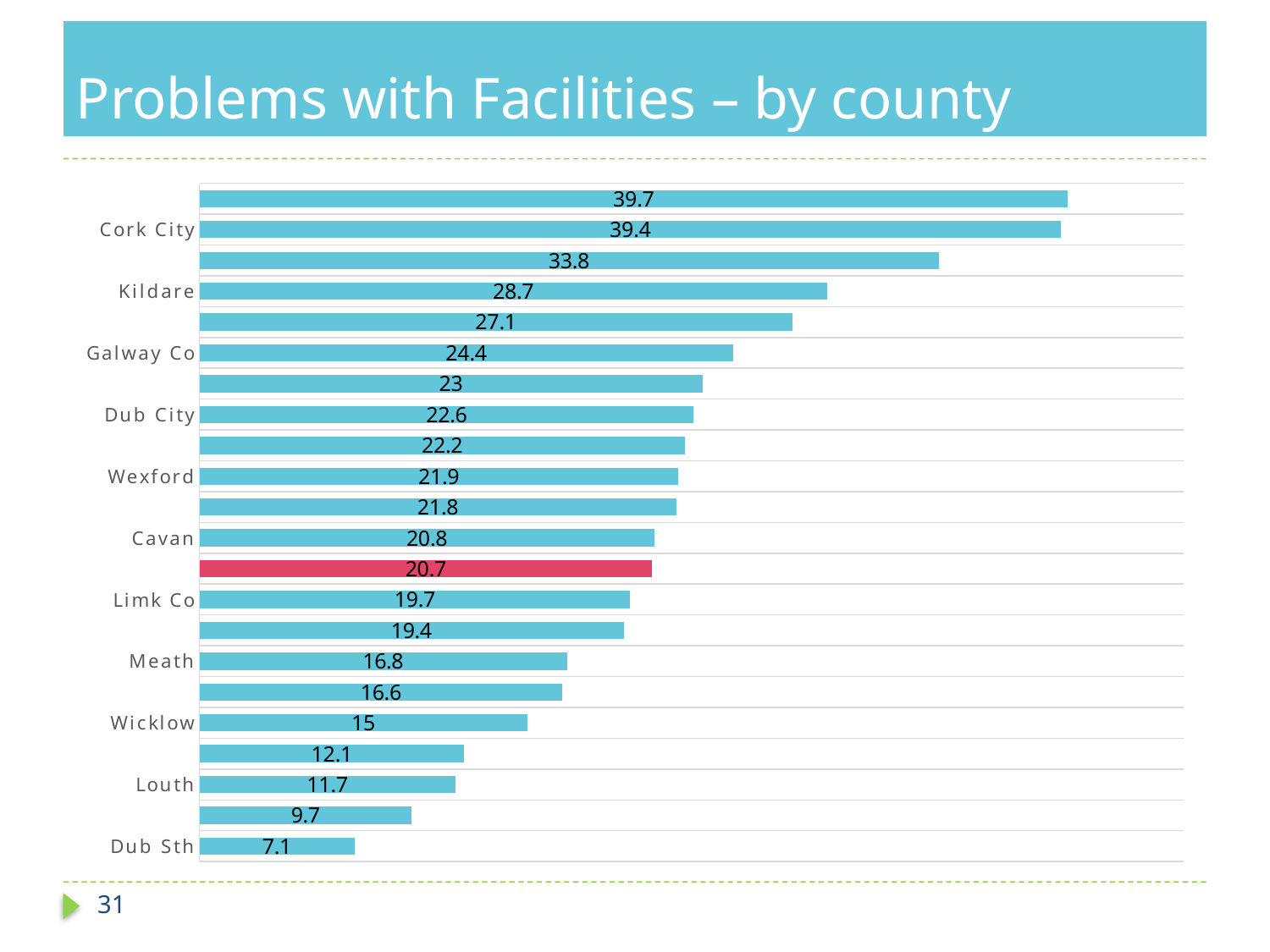
Which is larger, the value for Galway Co or the value for Dub City? Galway Co What is the value for Cork City? 39.4 What is the highest value shown on the chart? 39.7 What is the value of the bar highlighted in red? 20.7 What is the difference between the values for Meath and Louth? 5.1 What is the value for Wicklow? 15 How many bars are plotted on the chart? 22 What kind of chart is shown on the slide? Bar chart What is the value for Dub Sth? 7.1 What is the value for Kildare? 28.7 Which labelled county has the lowest value? Dub Sth What is the difference between the values for Cork City and Kildare? 10.7